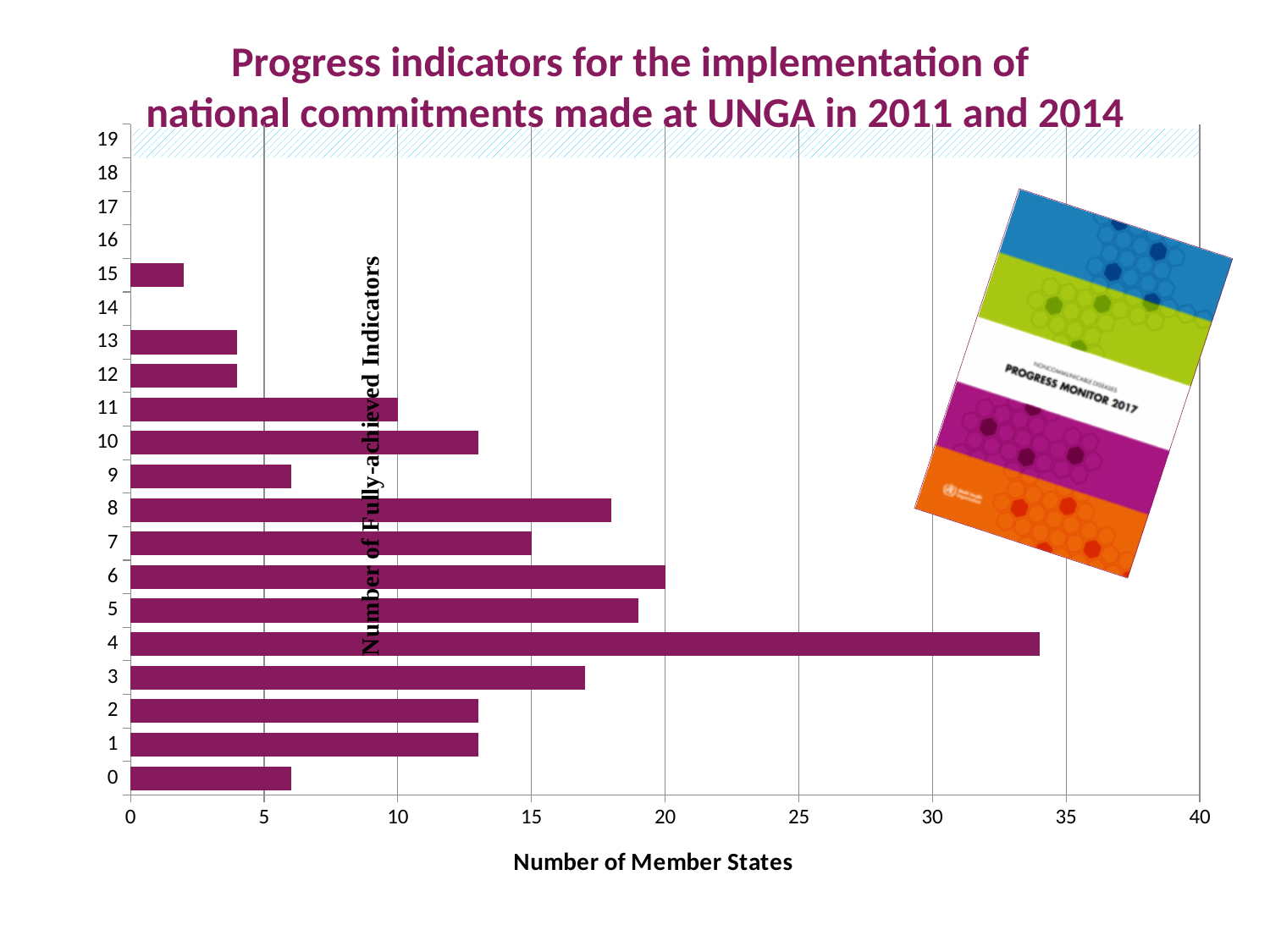
How many Member States have 7 fully-achieved indicators? 15 How many Member States have 6 fully-achieved indicators? 20 Is the number of Member States with 15 fully-achieved indicators greater or less than 5? less What kind of chart is shown on the slide? bar chart Is the number of Member States with 4 fully-achieved indicators greater or less than 30? greater What is the title of the horizontal axis? Number of Member States Which has more Member States: 4 fully-achieved indicators or 5 fully-achieved indicators? 4 Which number of fully-achieved indicators has the highest number of Member States? 4 How many categories (numbers of fully-achieved indicators) are listed on the vertical axis? 20 How many Member States have 11 fully-achieved indicators? 10 Which has more Member States: 8 fully-achieved indicators or 9 fully-achieved indicators? 8 Is the number of Member States with 8 fully-achieved indicators greater or less than 15? greater